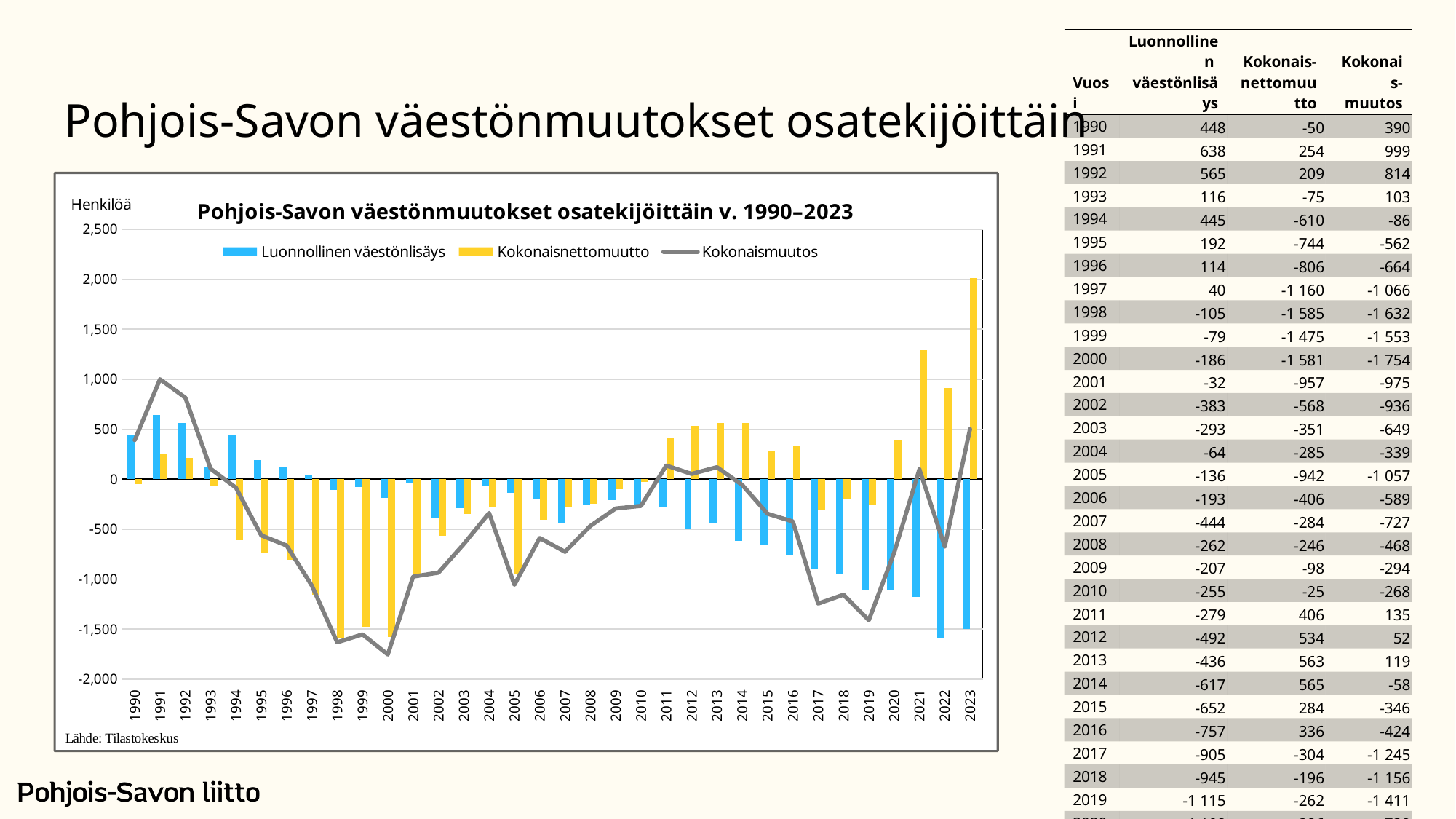
Which is larger, the Luonnollinen väestönlisäys for 1990 or for 1991? 1991 What kind of chart is shown on the slide? A combined bar and line chart What is the Kokonaismuutos value for 2000? -1 754 What is the title of the chart? Pohjois-Savon väestönmuutokset osatekijöittäin v. 1990–2023 Does the Kokonaismuutos line rise or fall from 1991 to 2000? fall In which year is the Kokonaisnettomuutto bar highest? 2023 Which series is drawn as a grey line in the chart? Kokonaismuutos Is the Luonnollinen väestönlisäys value for 2022 greater or less than -1,500? less Is the Kokonaisnettomuutto value for 2023 greater or less than 1,500? greater How many years are plotted along the x axis of the chart? 34 In which year does the Kokonaismuutos line reach its lowest point? 2000 How many series does the chart legend list? 3